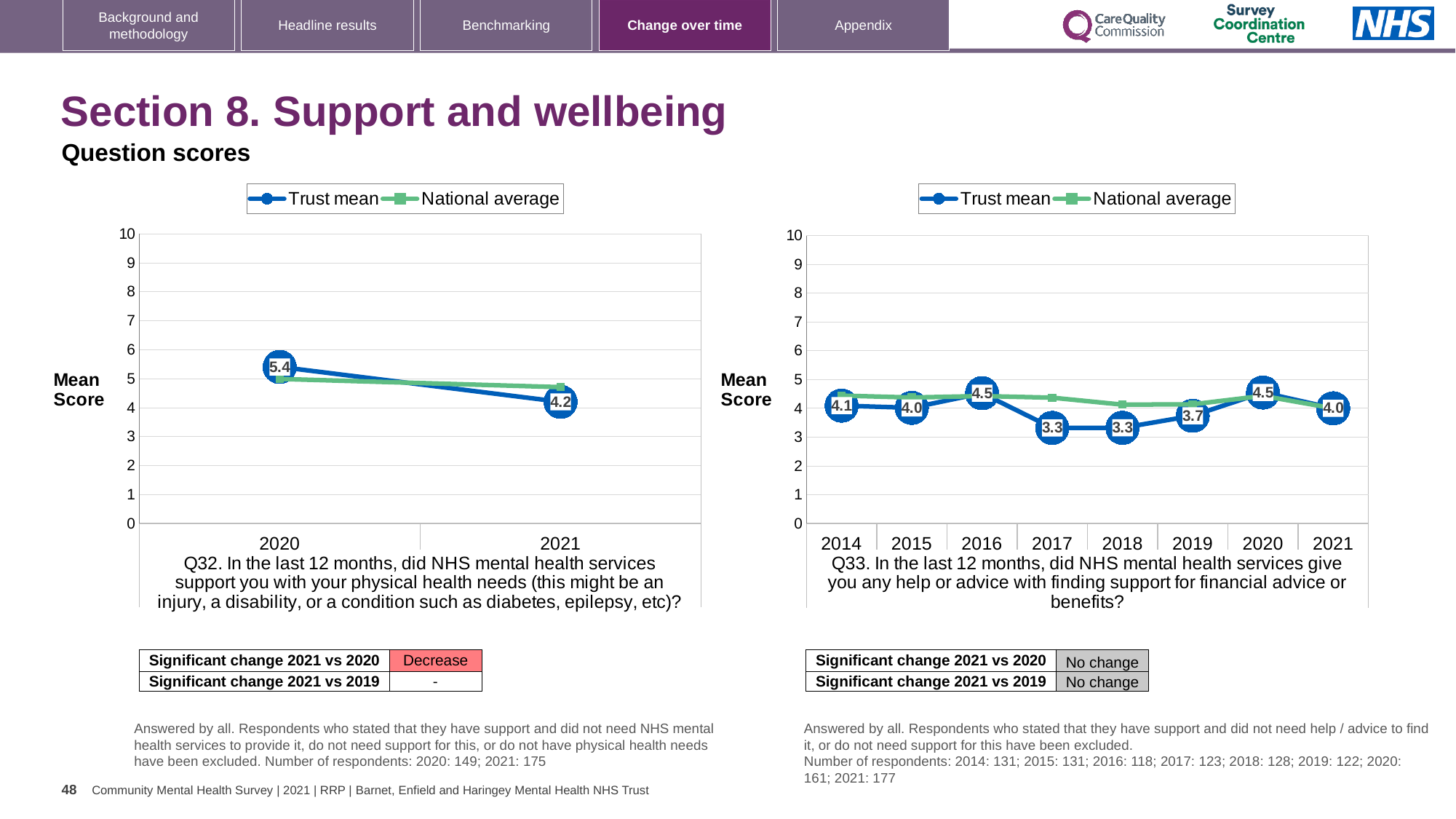
In the Q33 chart on the right, which year has the lowest Trust mean? 2017 and 2018 In the Q32 chart on the left, what is the Trust mean for 2021? 4.2 What type of chart is the Q33 chart on the right? line chart In the Q32 chart on the left, by how much did the Trust mean fall from 2020 to 2021? 1.2 In the Q32 chart on the left, what is the Trust mean for 2020? 5.4 In the Q33 chart on the right, what is the Trust mean for 2019? 3.7 In the Q33 chart on the right, what is the difference between the Trust mean in 2020 and in 2021? 0.5 In the Q32 chart on the left, does the Trust mean rise or fall from 2020 to 2021? fall How many series does the legend of the Q32 chart on the left list? 2 In the Q33 chart on the right, is the Trust mean for 2016 larger or smaller than the Trust mean for 2015? larger In the Q33 chart on the right, how many years are plotted on the x axis? 8 In the Q33 chart on the right, what is the Trust mean for 2017? 3.3